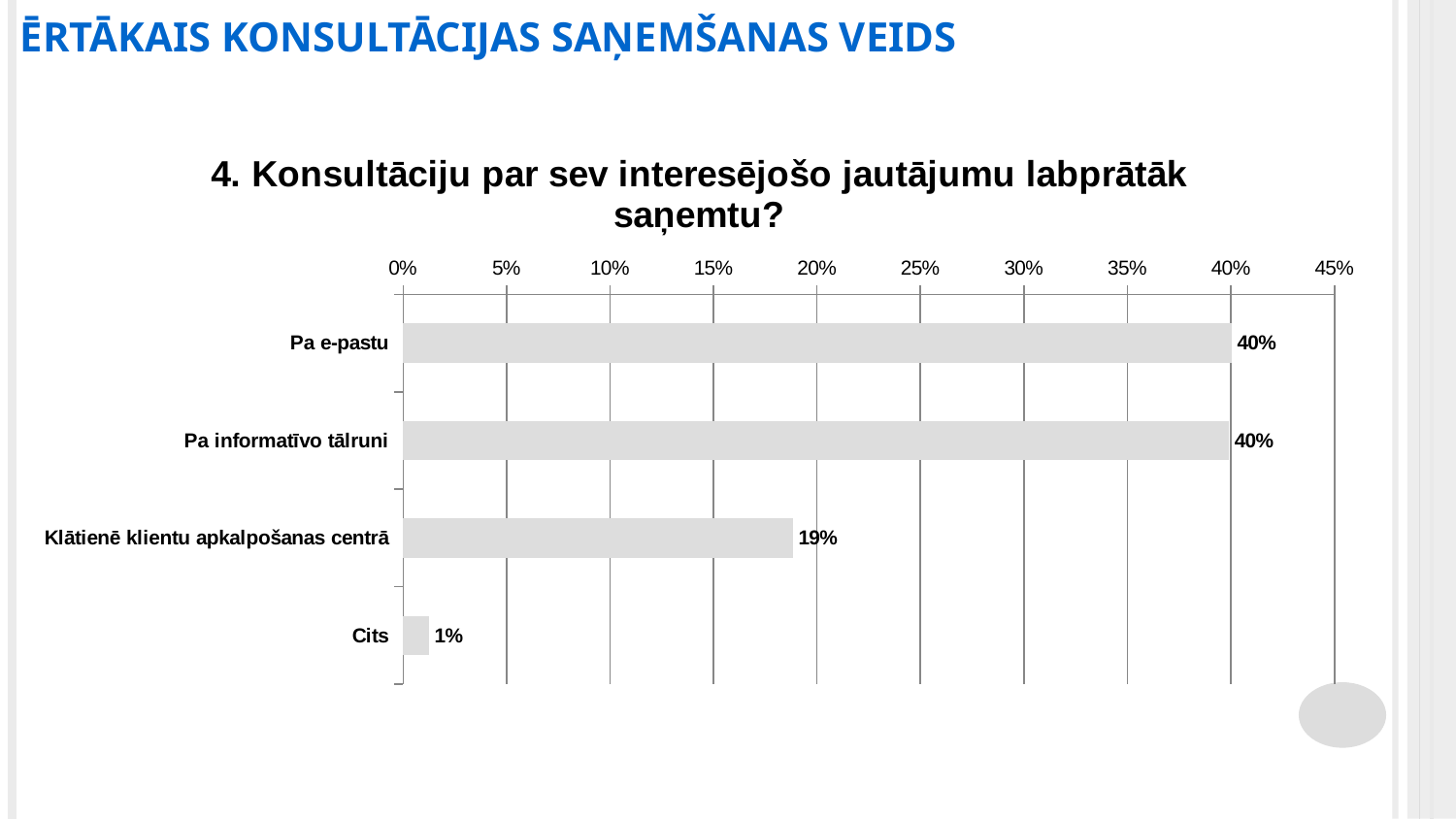
Is the value for Klātienē klientu apkalpošanas centrā greater or less than 20%? less What is the value for Cits? 1% What is the title of the chart? 4. Konsultāciju par sev interesējošo jautājumu labprātāk saņemtu? What kind of chart is shown on the slide? bar chart What is the difference between the values for Klātienē klientu apkalpošanas centrā and Cits? 18% Which is larger, the value for Pa informatīvo tālruni or the value for Klātienē klientu apkalpošanas centrā? Pa informatīvo tālruni Which category has the lowest value? Cits How many categories are shown in the chart? 4 What is the value for Klātienē klientu apkalpošanas centrā? 19% What is the value for Pa e-pastu? 40% What is the value for Pa informatīvo tālruni? 40% What is the difference between the values for Pa e-pastu and Klātienē klientu apkalpošanas centrā? 21%